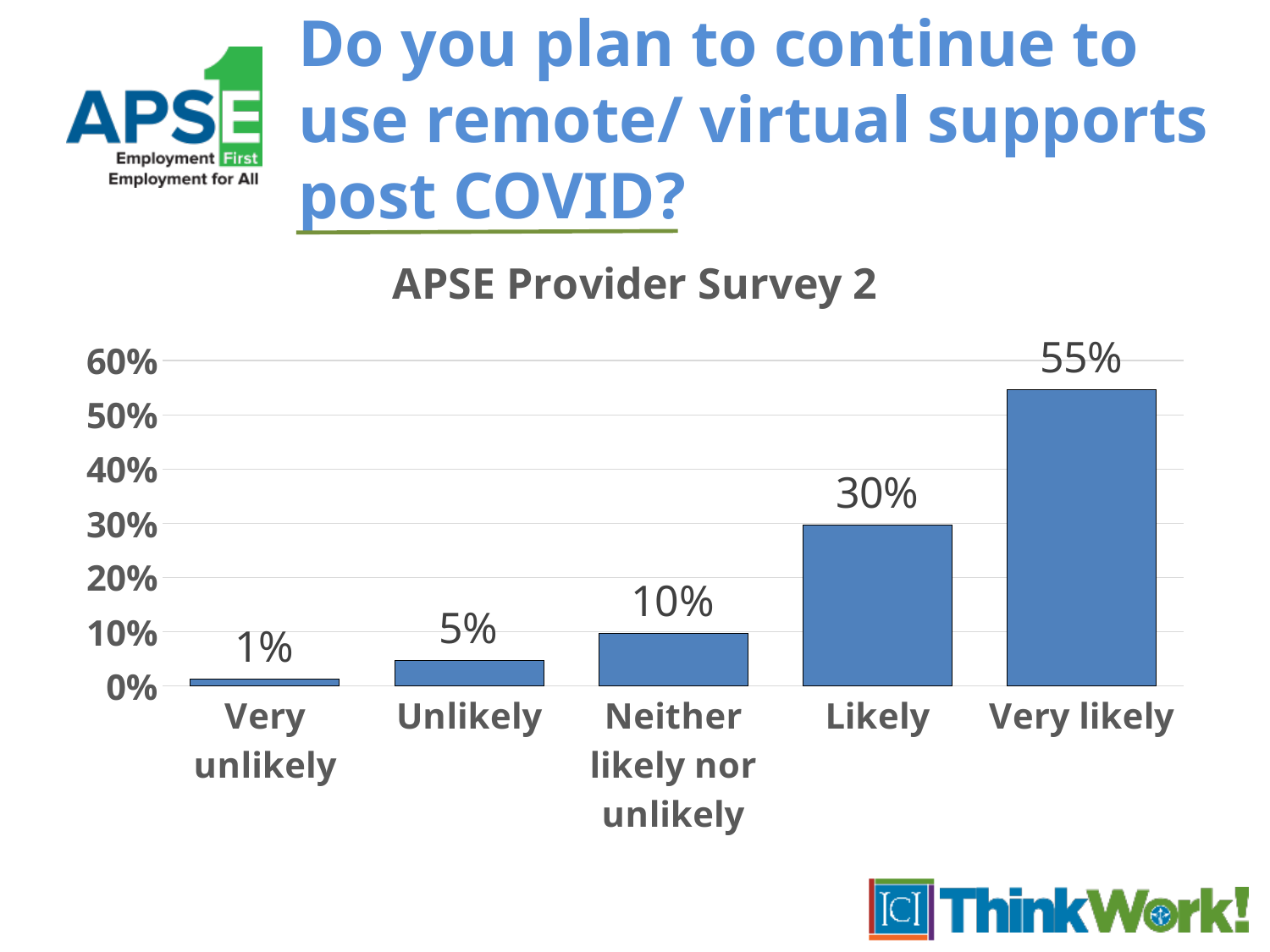
What percentage of respondents answered "Very likely"? 55% What is the difference between the "Very likely" and "Likely" values? 25% What kind of chart is shown on the slide? Bar chart What is the value for the "Likely" category? 30% How many categories are shown on the x axis? 5 Do the values rise or fall moving from left to right along the x axis? Rise What is the value for "Very unlikely"? 1% Which is larger, the value for "Unlikely" or the value for "Neither likely nor unlikely"? Neither likely nor unlikely What is the difference between the "Unlikely" and "Very unlikely" values? 4% Which category has the highest value? Very likely What is the value for "Neither likely nor unlikely"? 10% Which category has the lowest value? Very unlikely